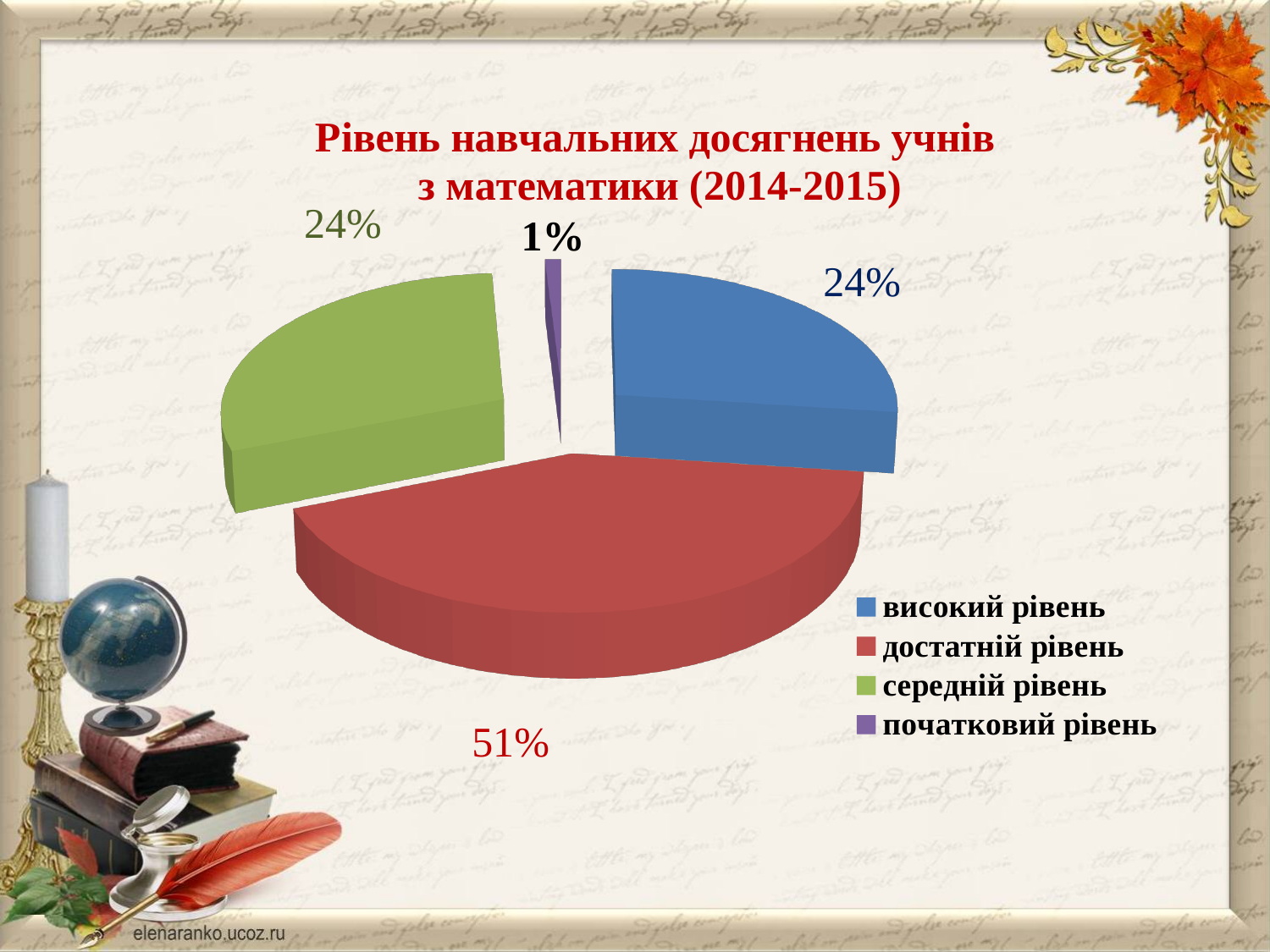
What colour represents the початковий рівень slice? purple What percentage of students are at the високий рівень? 24% Which is larger: the share for достатній рівень or the share for середній рівень? достатній рівень What percentage of students are at the достатній рівень? 51% What kind of chart is shown on the slide? pie chart Which level has the largest share of the pie? достатній рівень What is the difference in percentage points between достатній рівень and високий рівень? 27 What percentage of students are at the початковий рівень? 1% What percentage of students are at the середній рівень? 24% Which level has the smallest share of the pie? початковий рівень What is the title of the chart? Рівень навчальних досягнень учнів з математики (2014-2015) How many categories does the legend list? 4